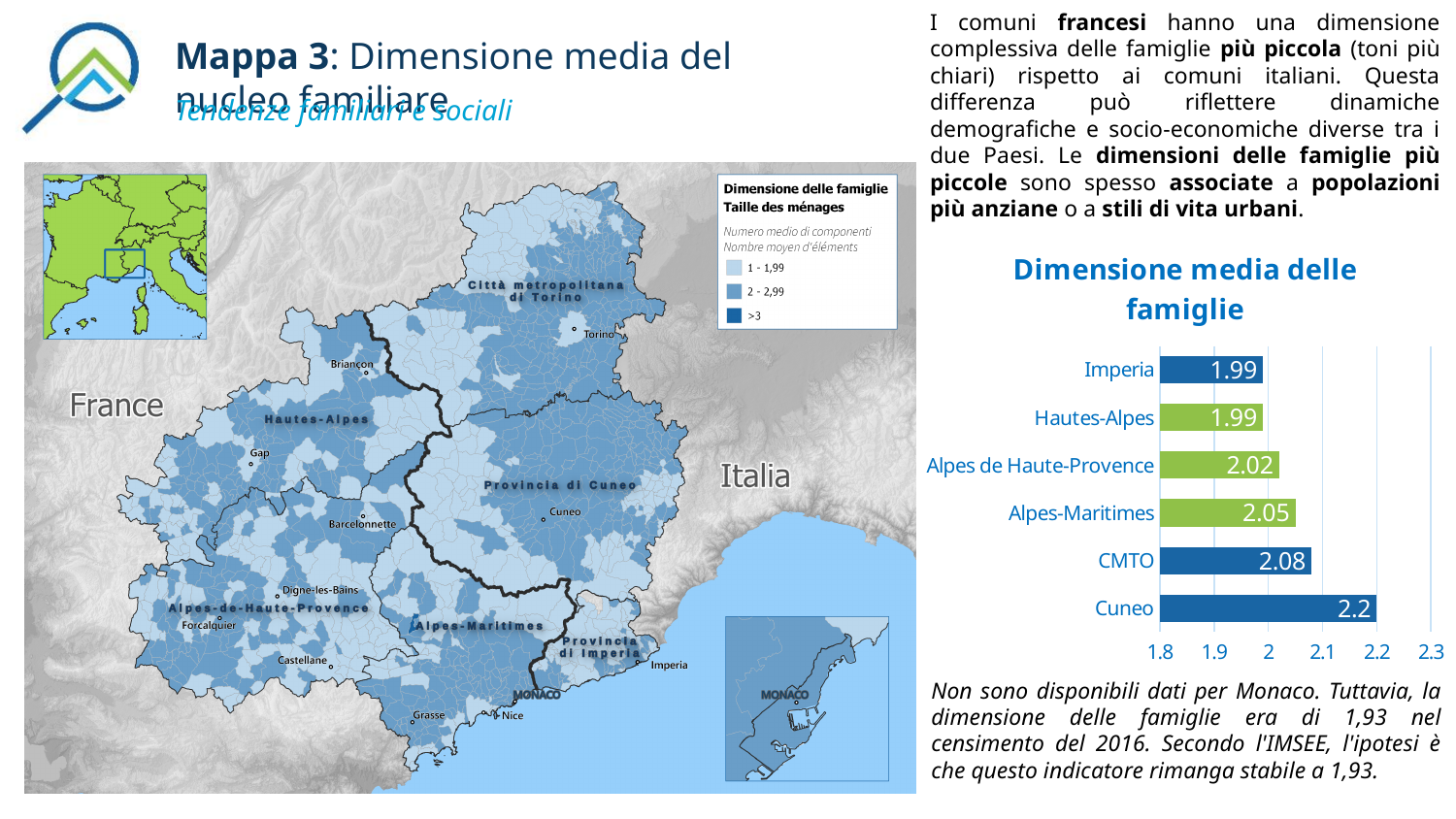
In the chart 'Dimensione media delle famiglie', what is the value for CMTO? 2.08 In the chart 'Dimensione media delle famiglie', what is the value for Alpes-Maritimes? 2.05 In the chart 'Dimensione media delle famiglie', what is the value for Alpes de Haute-Provence? 2.02 In the chart 'Dimensione media delle famiglie', what is the value for Cuneo? 2.2 In the chart 'Dimensione media delle famiglie', what is the difference between the values for Cuneo and Imperia? 0.21 What kind of chart is 'Dimensione media delle famiglie'? Bar chart In the chart 'Dimensione media delle famiglie', how many categories are plotted? 6 In the chart 'Dimensione media delle famiglie', what is the difference between the values for CMTO and Alpes-Maritimes? 0.03 In the chart 'Dimensione media delle famiglie', which category has the highest value? Cuneo In the chart 'Dimensione media delle famiglie', what colour is the bar for Hautes-Alpes? Green In the chart 'Dimensione media delle famiglie', which is larger, the value for CMTO or the value for Alpes de Haute-Provence? CMTO In the chart 'Dimensione media delle famiglie', is the value for Cuneo greater or less than 2.1? greater